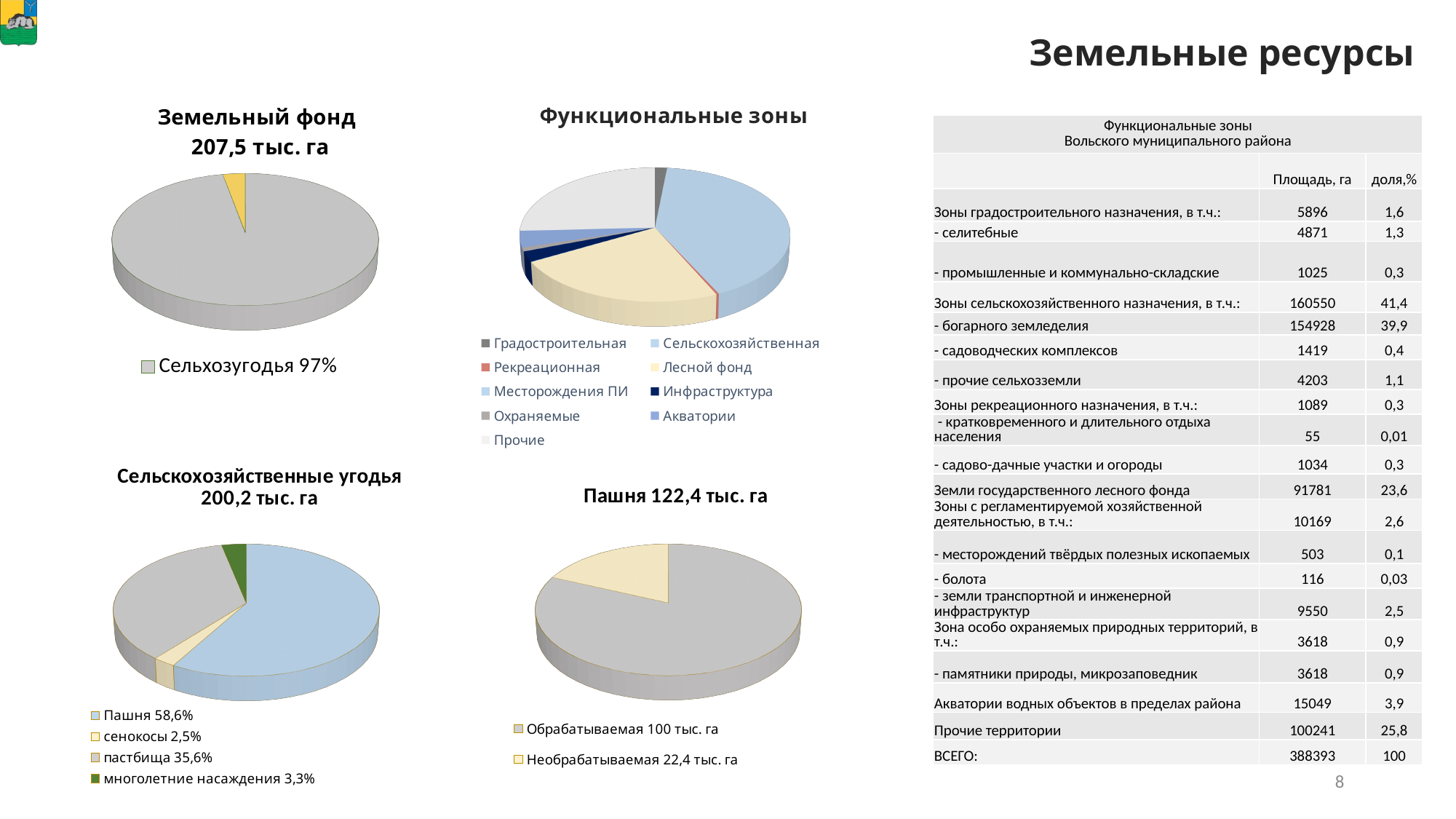
In the chart titled "Сельскохозяйственные угодья 200,2 тыс. га", which category has the smallest share? сенокосы In the chart titled "Сельскохозяйственные угодья 200,2 тыс. га", what share is shown for пастбища? 35,6% In the chart titled "Сельскохозяйственные угодья 200,2 тыс. га", how many categories does the legend list? 4 In the chart titled "Пашня 122,4 тыс. га", what is the difference between Обрабатываемая and Необрабатываемая? 77,6 тыс. га In the chart titled "Пашня 122,4 тыс. га", what value is shown for Необрабатываемая? 22,4 тыс. га In the chart titled "Пашня 122,4 тыс. га", which is larger, Обрабатываемая or Необрабатываемая? Обрабатываемая In the chart titled "Сельскохозяйственные угодья 200,2 тыс. га", which category has the largest share? Пашня In the chart titled "Сельскохозяйственные угодья 200,2 тыс. га", what share is shown for Пашня? 58,6% In the chart titled "Функциональные зоны", how many categories does the legend list? 9 What type of chart is the chart titled "Функциональные зоны"? Pie chart In the chart titled "Пашня 122,4 тыс. га", what value is shown for Обрабатываемая? 100 тыс. га In the chart titled "Земельный фонд 207,5 тыс. га", what share is shown for Сельхозугодья? 97%